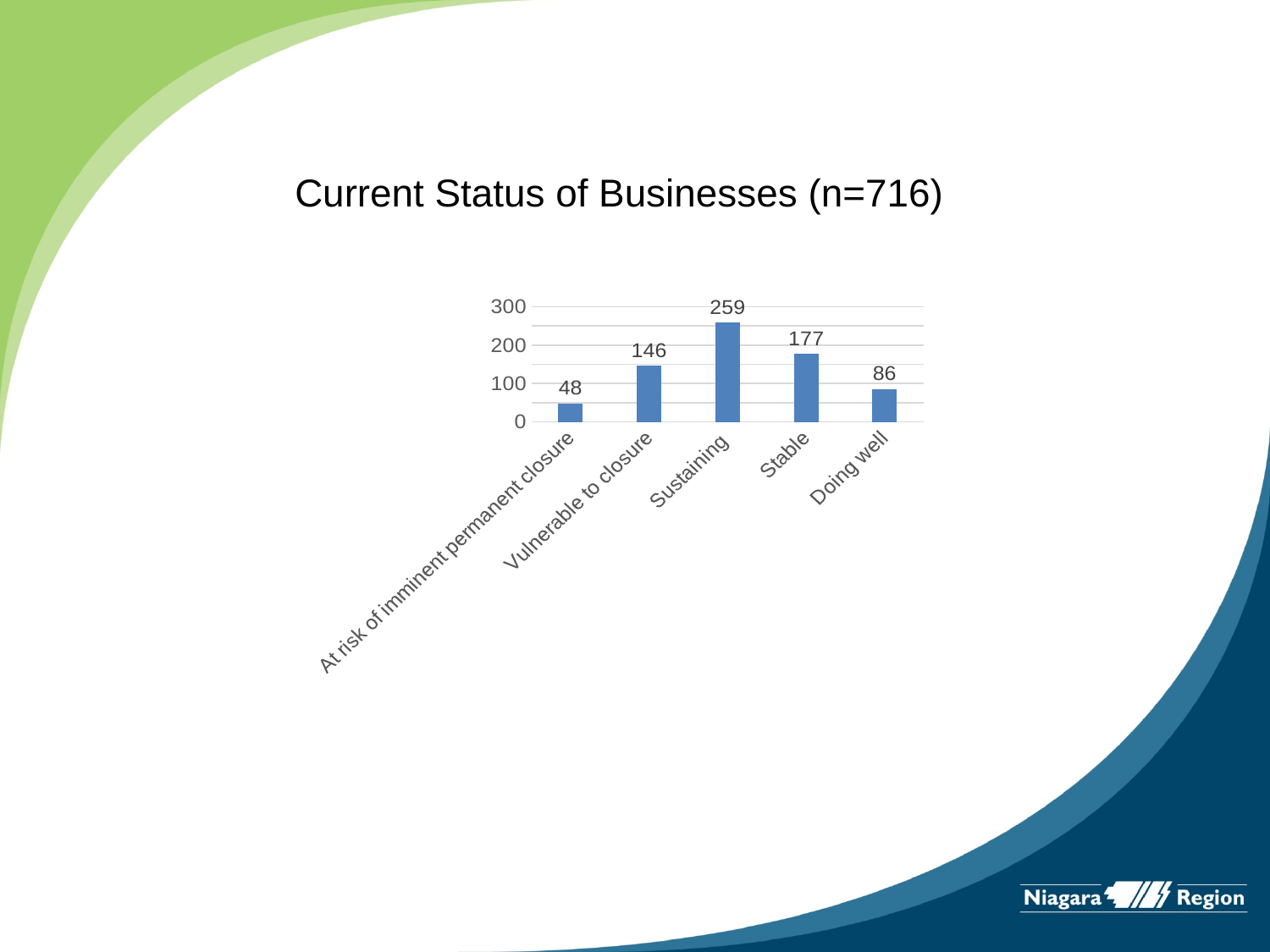
What is the value for Sustaining? 259 What is the value for Vulnerable to closure? 146 What kind of chart is shown on the slide? bar chart Which is larger, the value for Stable or the value for Vulnerable to closure? Stable What is the value for Doing well? 86 Which category has the lowest value? At risk of imminent permanent closure Is the value for Stable greater or less than 200? less How many categories are shown on the x axis? 5 Which category has the highest value? Sustaining What is the title of the chart? Current Status of Businesses (n=716) What is the value for At risk of imminent permanent closure? 48 What is the difference between the values for Sustaining and Stable? 82